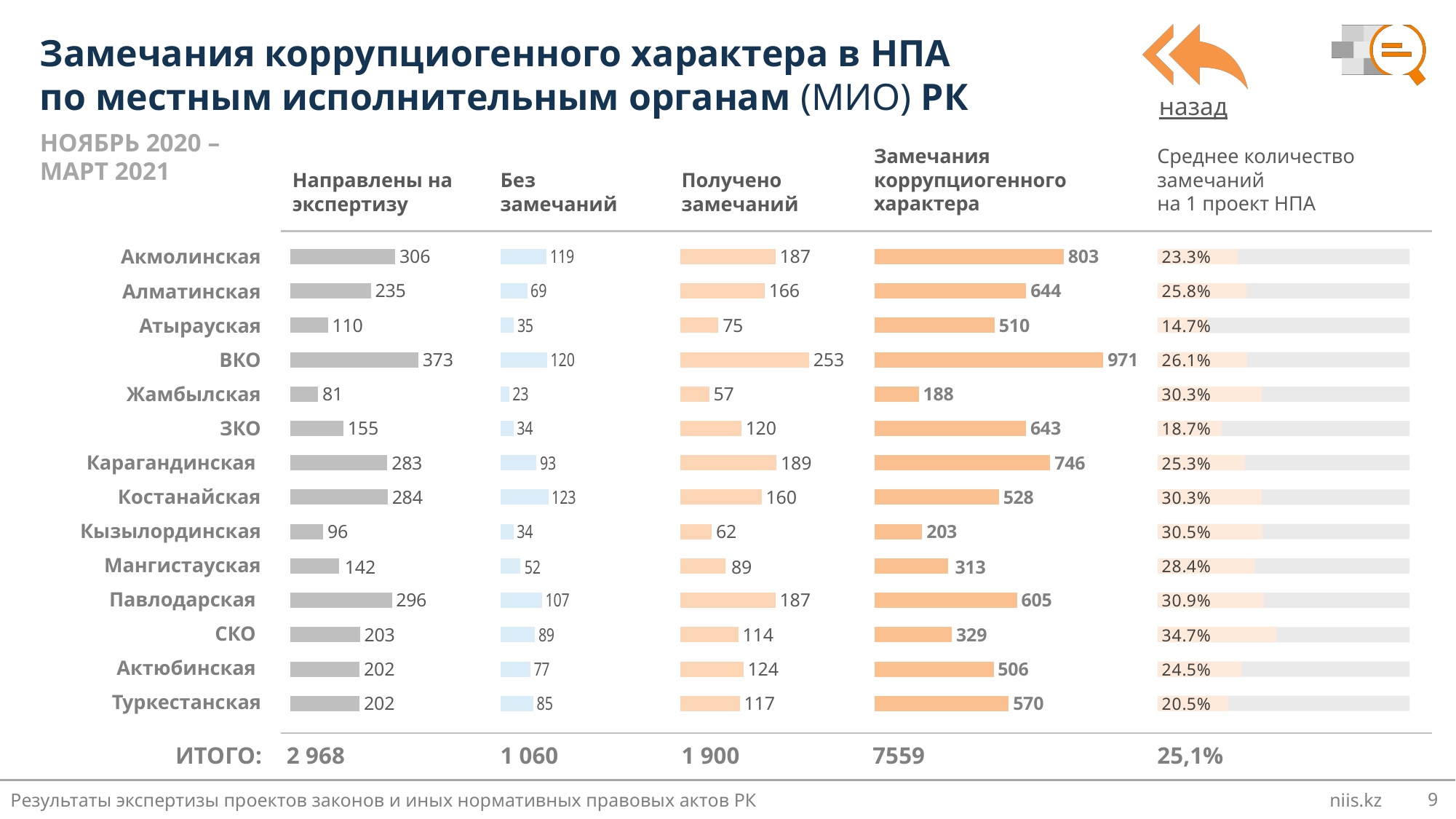
In the column "Без замечаний", what is the value for Костанайская? 123 In the column "Замечания коррупциогенного характера", which region has the lowest value? Жамбылская In the column "Получено замечаний", which is larger: Алматинская or ЗКО? Алматинская In the column "Замечания коррупциогенного характера", which region has the highest value? ВКО In the column "Среднее количество замечаний на 1 проект НПА", what is the value for Павлодарская? 30.9% In the column "Замечания коррупциогенного характера", what is the value for Карагандинская? 746 In the column "Среднее количество замечаний на 1 проект НПА", which region has the highest value? СКО How many regions are listed in the chart? 14 In the column "Замечания коррупциогенного характера", what is the difference between ВКО and Акмолинская? 168 In the column "Направлены на экспертизу", what is the value for ВКО? 373 What is the ИТОГО (total) value for the column "Замечания коррупциогенного характера"? 7559 In the column "Среднее количество замечаний на 1 проект НПА", which region has the lowest value? Атырауская